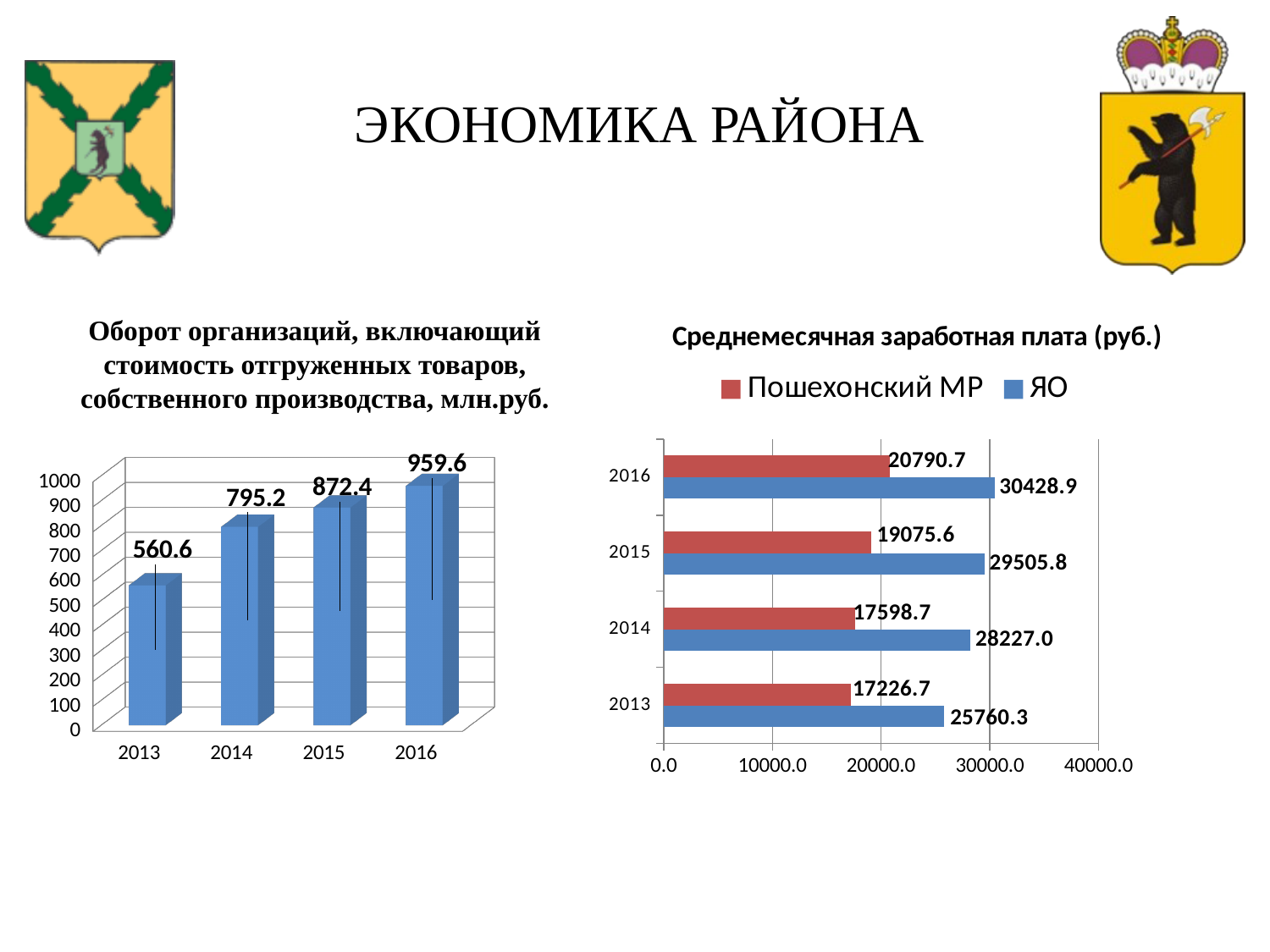
In the left chart (Оборот организаций), which year has the highest value? 2016 In the left chart (Оборот организаций), do the values rise or fall from 2013 to 2016? rise In the right chart (Среднемесячная заработная плата), which is larger in 2016: Пошехонский МР or ЯО? ЯО In the right chart (Среднемесячная заработная плата), what is the value for ЯО in 2015? 29505.8 In the left chart (Оборот организаций), how many years are shown? 4 In the right chart (Среднемесячная заработная плата), what is the value for Пошехонский МР in 2013? 17226.7 In the right chart (Среднемесячная заработная плата), how many series does the legend list? 2 In the right chart (Среднемесячная заработная плата), what is the difference between ЯО and Пошехонский МР in 2014? 10628.3 In the left chart (Оборот организаций), which year has the lowest value? 2013 In the left chart (Оборот организаций), what is the difference between the 2016 and 2013 values? 399.0 In the left chart (Оборот организаций), what is the value for 2014? 795.2 What kind of chart is the right chart (Среднемесячная заработная плата)? bar chart